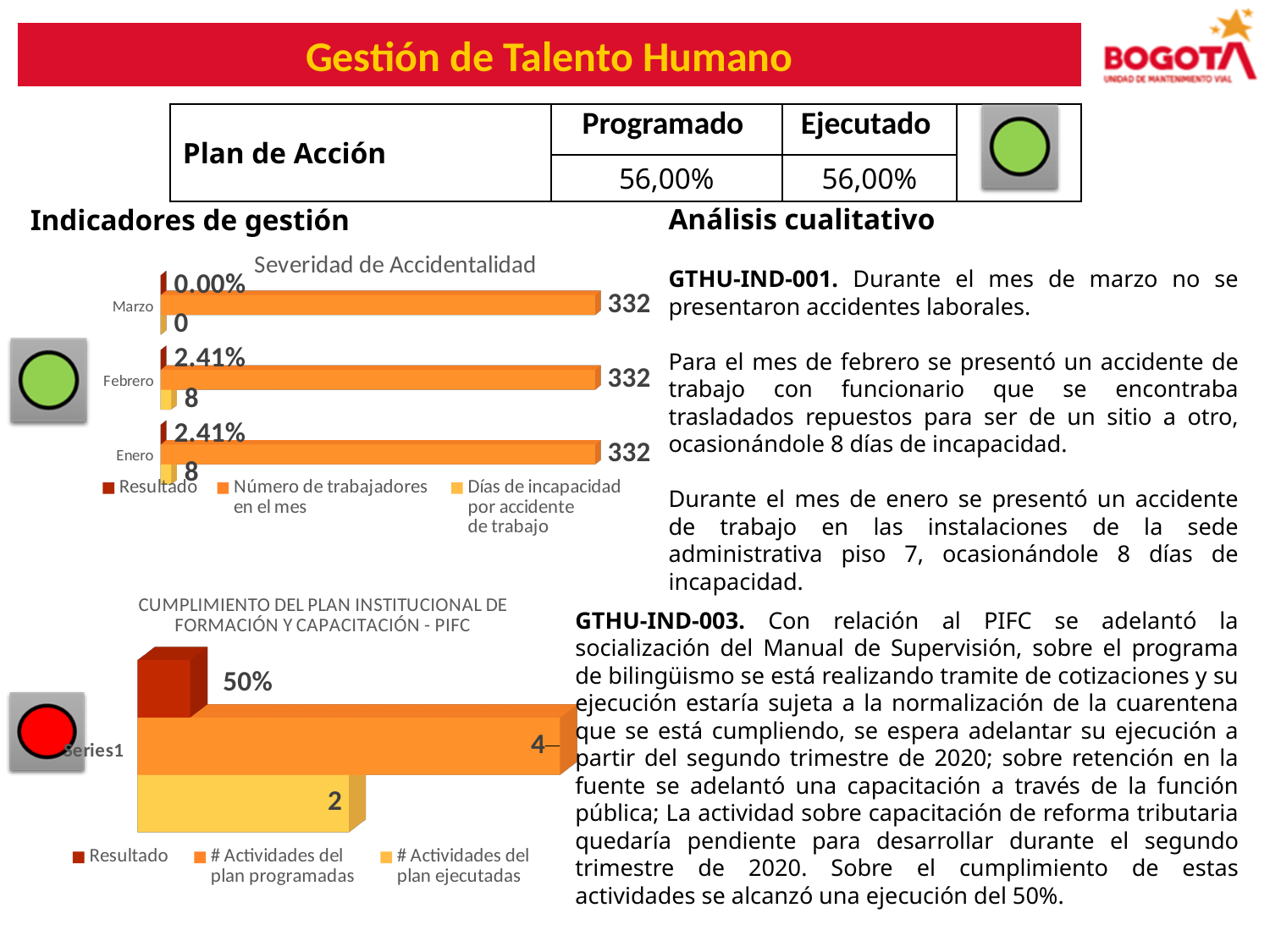
In the 'Severidad de Accidentalidad' chart, how many series does the legend list? 3 In the 'Severidad de Accidentalidad' chart, how many months are shown on the axis? 3 In the 'Severidad de Accidentalidad' chart, how many 'Días de incapacidad por accidente de trabajo' are shown for Enero? 8 In the 'Severidad de Accidentalidad' chart, what is the 'Resultado' value for Febrero? 2.41% What type of chart is the 'CUMPLIMIENTO DEL PLAN INSTITUCIONAL DE FORMACIÓN Y CAPACITACIÓN - PIFC' chart? Bar chart In the 'CUMPLIMIENTO DEL PLAN INSTITUCIONAL DE FORMACIÓN Y CAPACITACIÓN - PIFC' chart, what is the 'Resultado' value? 50% In the 'CUMPLIMIENTO DEL PLAN INSTITUCIONAL DE FORMACIÓN Y CAPACITACIÓN - PIFC' chart, what is the value for '# Actividades del plan programadas'? 4 In the 'Severidad de Accidentalidad' chart, which month has the lowest 'Días de incapacidad por accidente de trabajo' value? Marzo In the 'Severidad de Accidentalidad' chart, what is the difference in 'Días de incapacidad por accidente de trabajo' between Febrero and Marzo? 8 In the 'Severidad de Accidentalidad' chart, what is the 'Resultado' value for Marzo? 0.00% In the 'CUMPLIMIENTO DEL PLAN INSTITUCIONAL DE FORMACIÓN Y CAPACITACIÓN - PIFC' chart, which is larger: '# Actividades del plan programadas' or '# Actividades del plan ejecutadas'? # Actividades del plan programadas In the 'Severidad de Accidentalidad' chart, what is the value of 'Número de trabajadores en el mes' for Marzo? 332